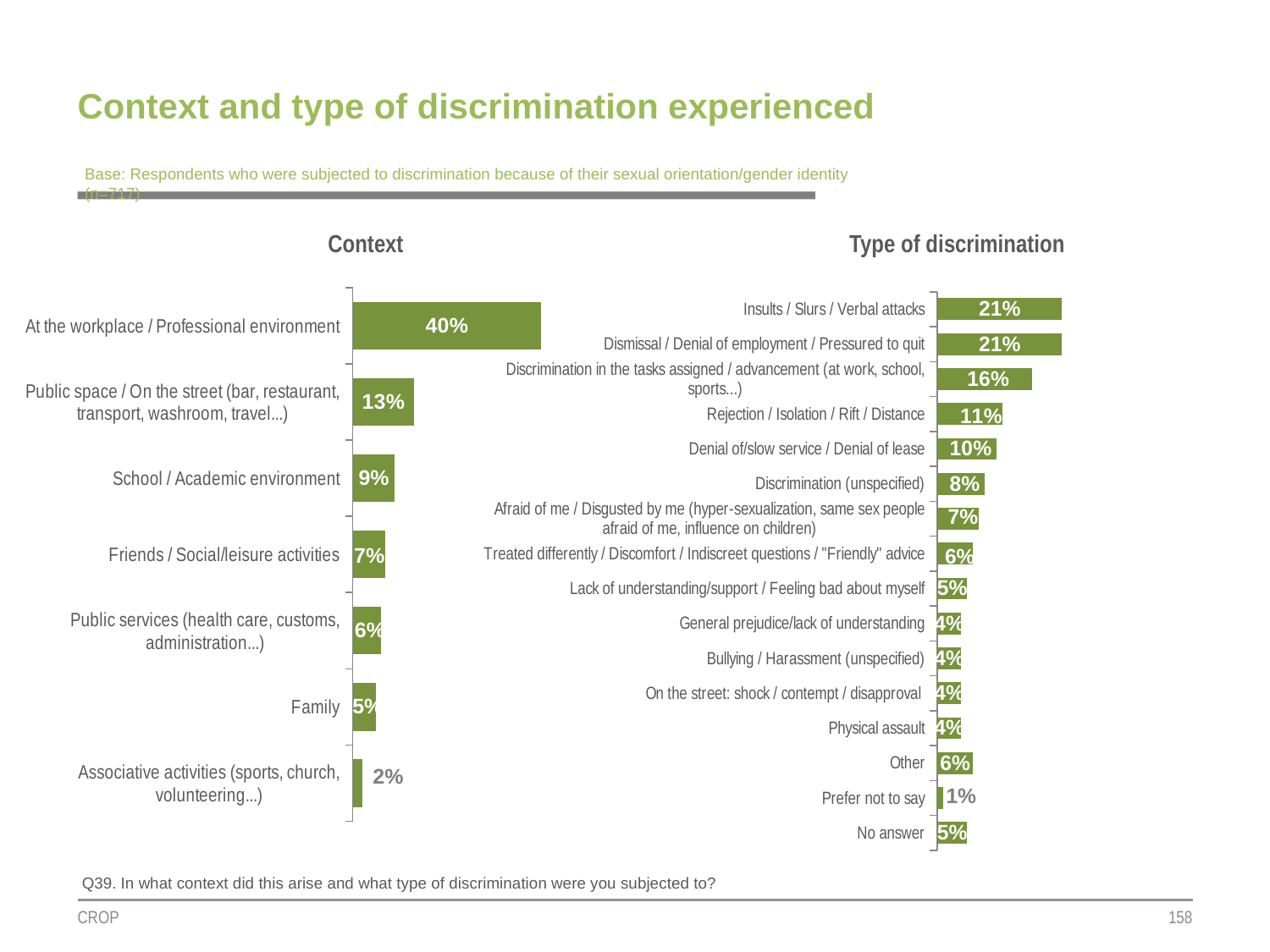
In the Context chart, how many categories are shown? 7 In the Type of discrimination chart, what is the difference between Insults / Slurs / Verbal attacks and Discrimination in the tasks assigned / advancement? 5% In the Type of discrimination chart, how many categories are shown? 16 In the Context chart, what is the value for School / Academic environment? 9% In the Type of discrimination chart, which category has the lowest value? Prefer not to say In the Context chart, which category has the lowest value? Associative activities (sports, church, volunteering...) In the Type of discrimination chart, what is the value for Rejection / Isolation / Rift / Distance? 11% What kind of chart is the Context chart? Bar chart In the Type of discrimination chart, what percentage is shown for Physical assault? 4% In the Context chart, what is the difference between the values for At the workplace / Professional environment and Public space / On the street? 27% In the Context chart, what percentage is shown for At the workplace / Professional environment? 40% In the Type of discrimination chart, which is larger: Denial of/slow service / Denial of lease or Discrimination (unspecified)? Denial of/slow service / Denial of lease